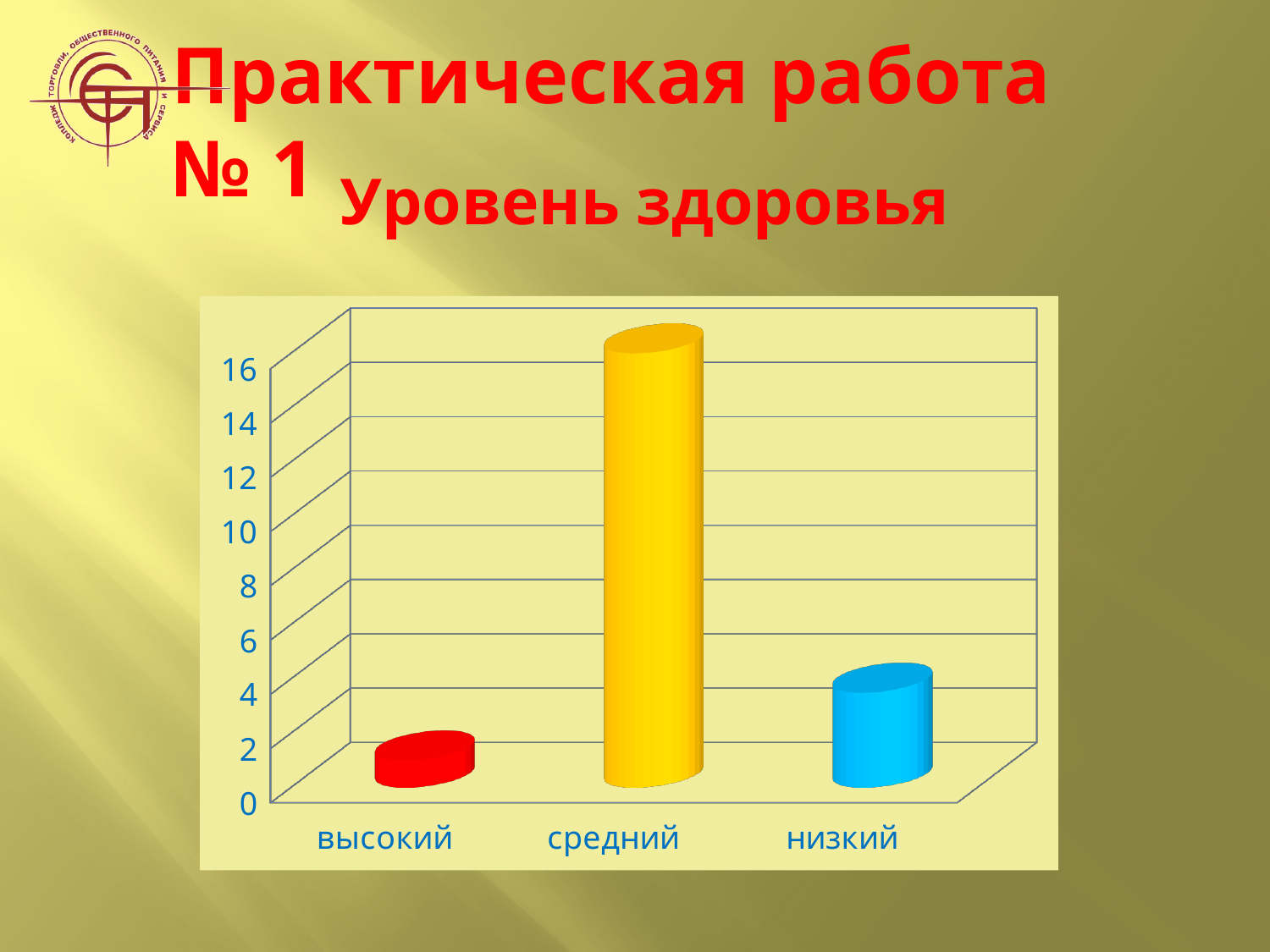
Is the value for средний greater or less than 14? greater What colour is the bar for средний? yellow What kind of chart is shown on the slide? bar chart Which category has the highest bar? средний Which is larger, the value for низкий or the value for высокий? низкий Is the value for высокий greater or less than 4? less How many categories are shown on the x axis of the chart? 3 Which category has the lowest bar? высокий Which is larger, the value for средний or the value for низкий? средний Is the value for низкий greater or less than 8? less